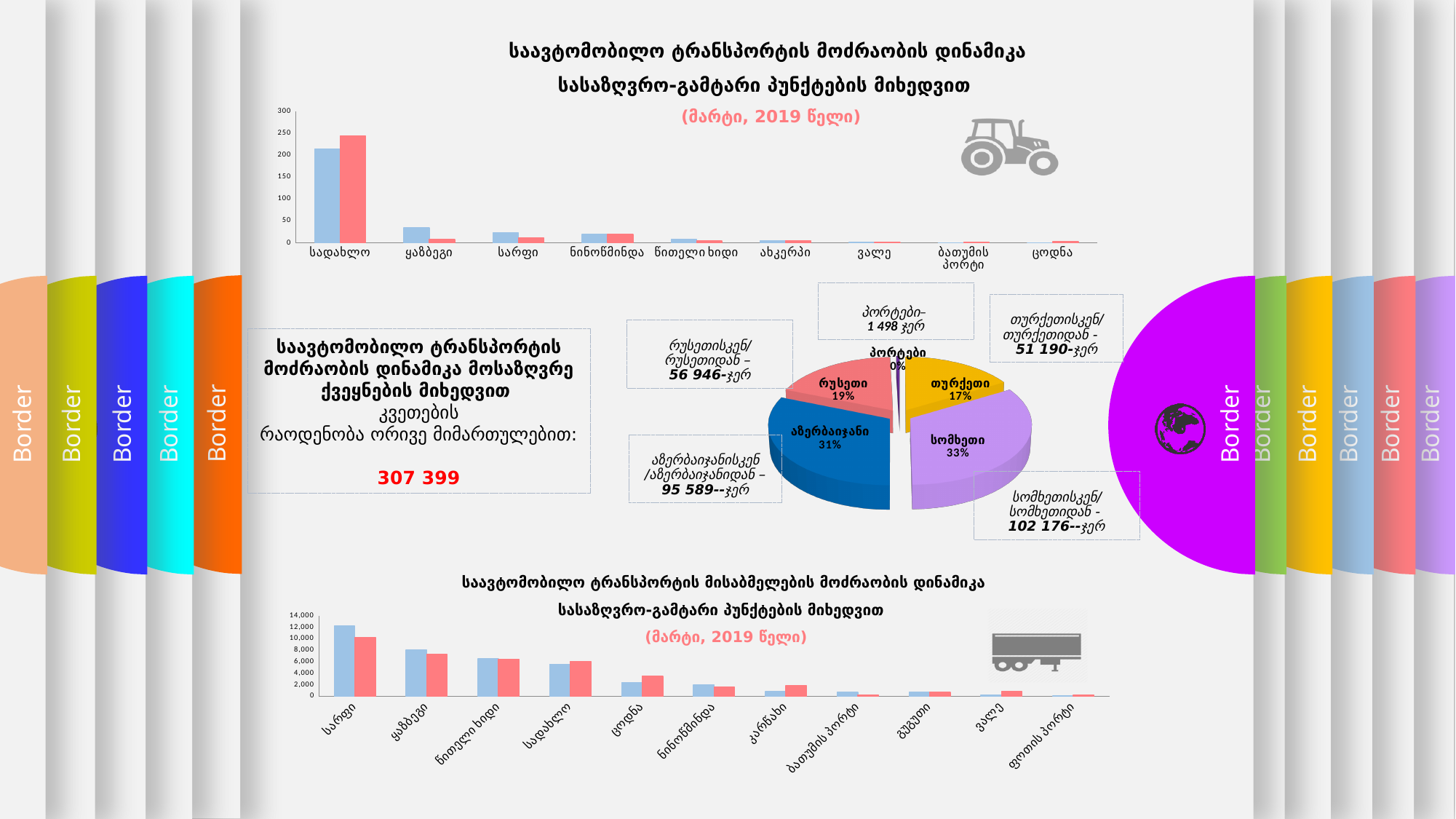
In the bottom bar chart, which category has the highest values? სარფი What type of chart is the top chart on the slide? bar chart In the top bar chart, which category has the highest values? სადახლო In the pie chart, what share does აზერბაიჯანი have? 31% How many categories are shown on the x axis of the top bar chart? 9 In the pie chart, what share does სომხეთი have? 33% In the top bar chart, is the value of the blue bar for ყაზბეგი greater or less than 50? less How many slices does the pie chart have? 5 In the top bar chart, is the value of the blue bar for სადახლო greater or less than 200? greater In the bottom bar chart, is the value of the blue bar for სარფი greater or less than 10,000? greater In the pie chart, which slice is the largest? სომხეთი In the pie chart, which slice is the smallest? პორტები